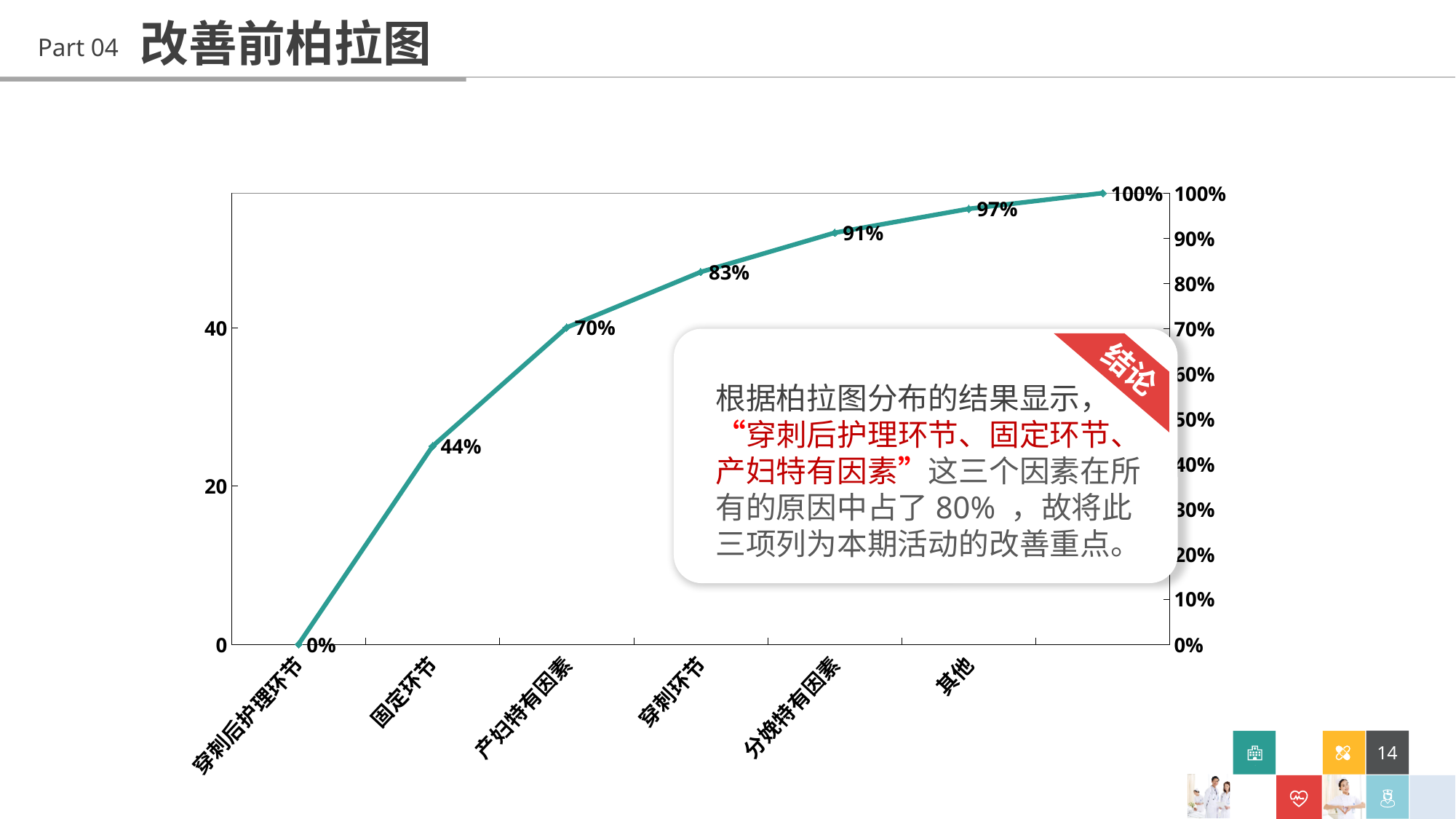
What is the data label on the line at 产妇特有因素? 70% What is the data label on the line at 其他? 97% What is the data label on the line at 固定环节? 44% What is the difference between the labelled values at 产妇特有因素 (70%) and 固定环节 (44%)? 26% What is the lowest value labelled on the cumulative line? 0% What type of chart is shown on the slide? line chart What is the title of the slide containing the chart? 改善前柏拉图 How many category labels are shown on the x axis? 6 How many data points are labelled on the cumulative line? 7 Do the values on the line rise or fall from left to right along the x axis? rise What is the highest value labelled on the cumulative line? 100% What is the data label on the line at 穿刺环节? 83%